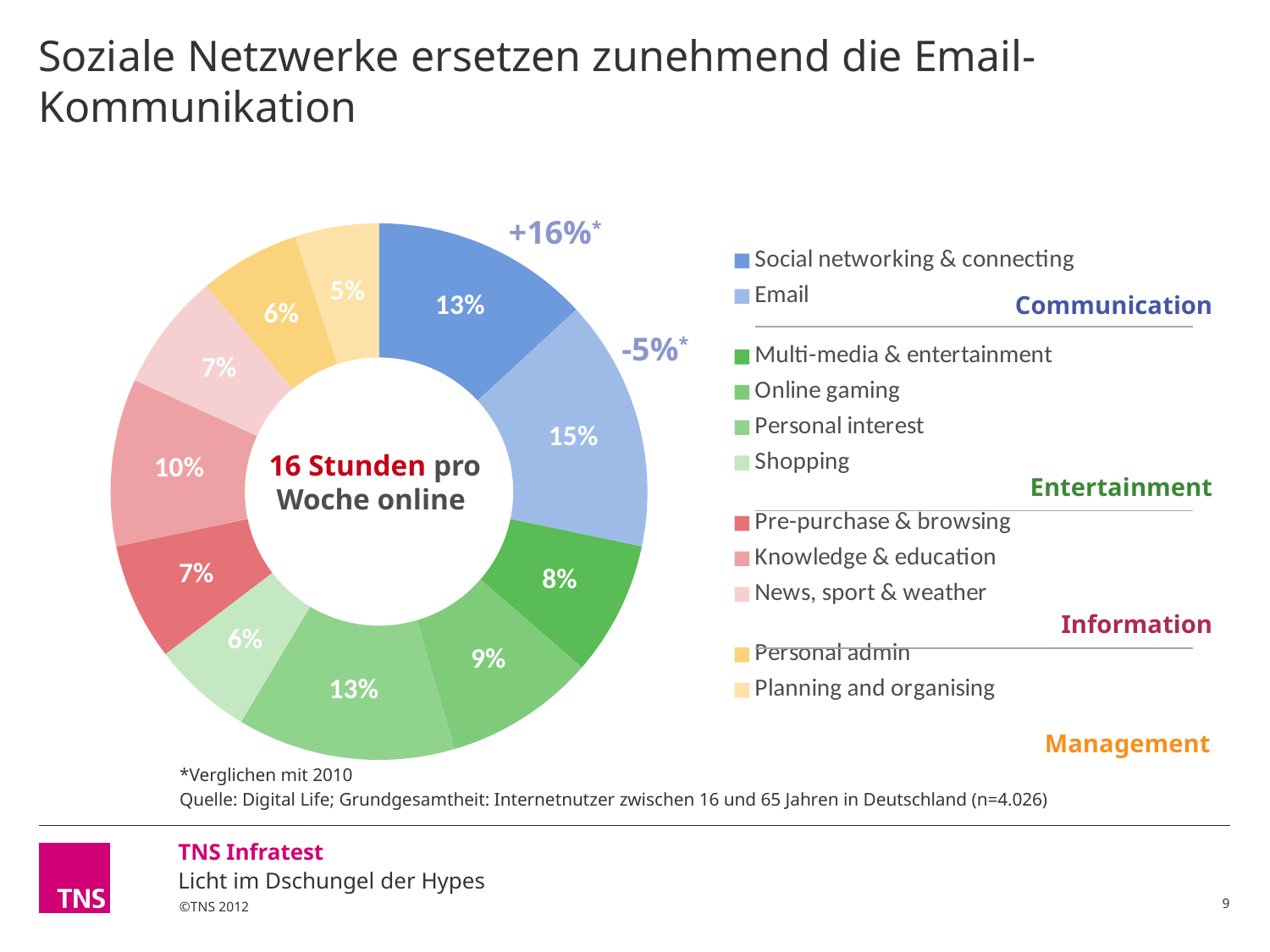
What kind of chart is shown on the slide? Pie (donut) chart What percentage is shown for Planning and organising? 5% How many categories does the legend list? 11 Which category has the smallest share of the chart? Planning and organising What text is shown in the centre of the donut chart? 16 Stunden pro Woche online Which category has the largest share of the chart? Email What percentage is shown for Email? 15% What percentage is shown for Social networking & connecting? 13% Which is larger, the share for Online gaming or the share for Shopping? Online gaming What percentage is shown for Knowledge & education? 10% What change compared with 2010 is annotated next to the Social networking & connecting slice? +16% What is the difference in percentage points between Email and Multi-media & entertainment? 7